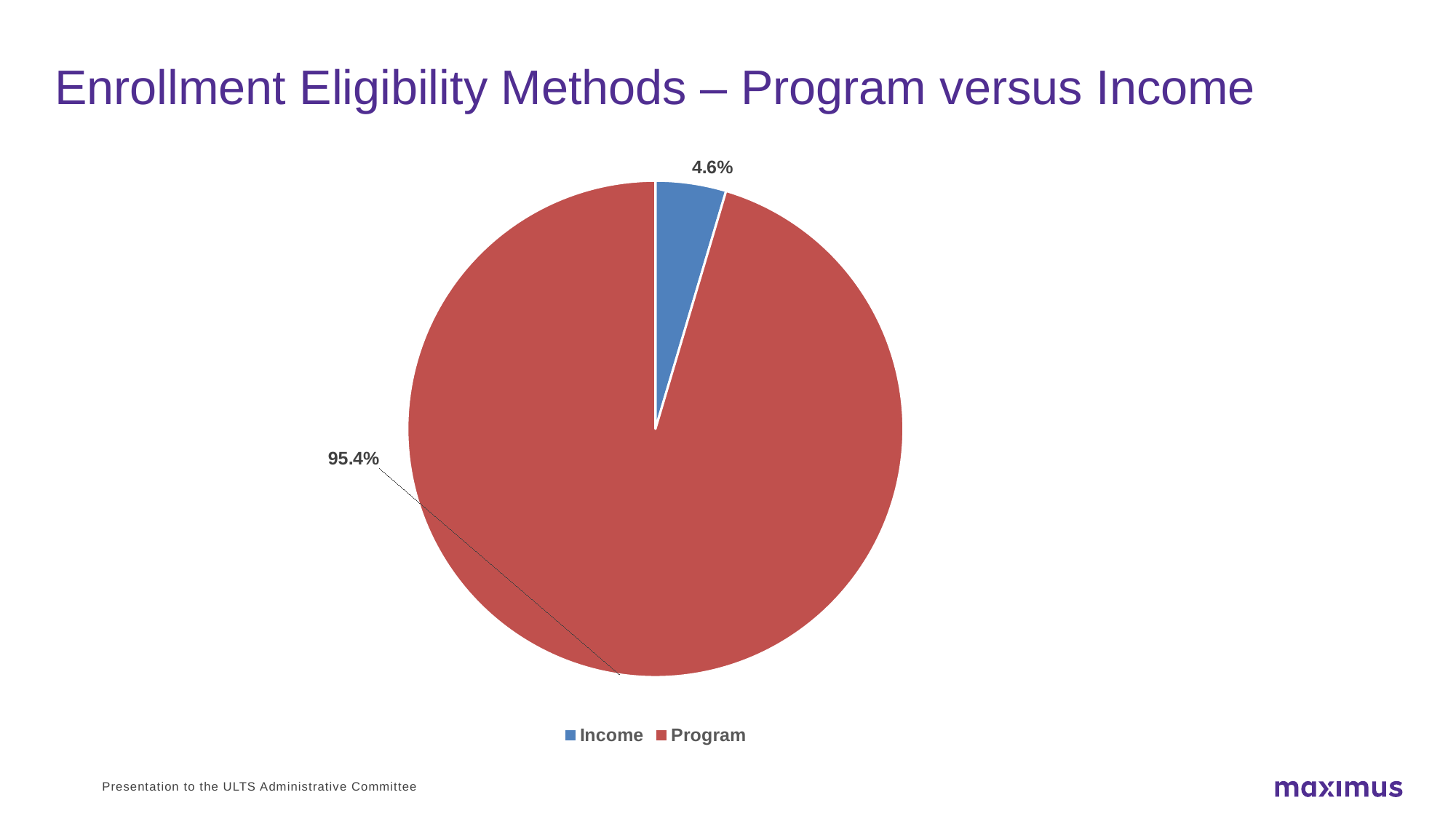
What kind of chart is shown on the slide? pie chart Which slice is larger, Income or Program? Program What share of the pie does Income represent? 4.6% Which category has the largest slice of the pie? Program What is the difference in percentage points between the Program and Income slices? 90.8 What is the title of the slide containing the chart? Enrollment Eligibility Methods – Program versus Income How many entries does the legend list? 2 How many categories does the pie chart show? 2 What share of the pie does Program represent? 95.4% What colour is the Income slice? blue Which category has the smallest slice of the pie? Income